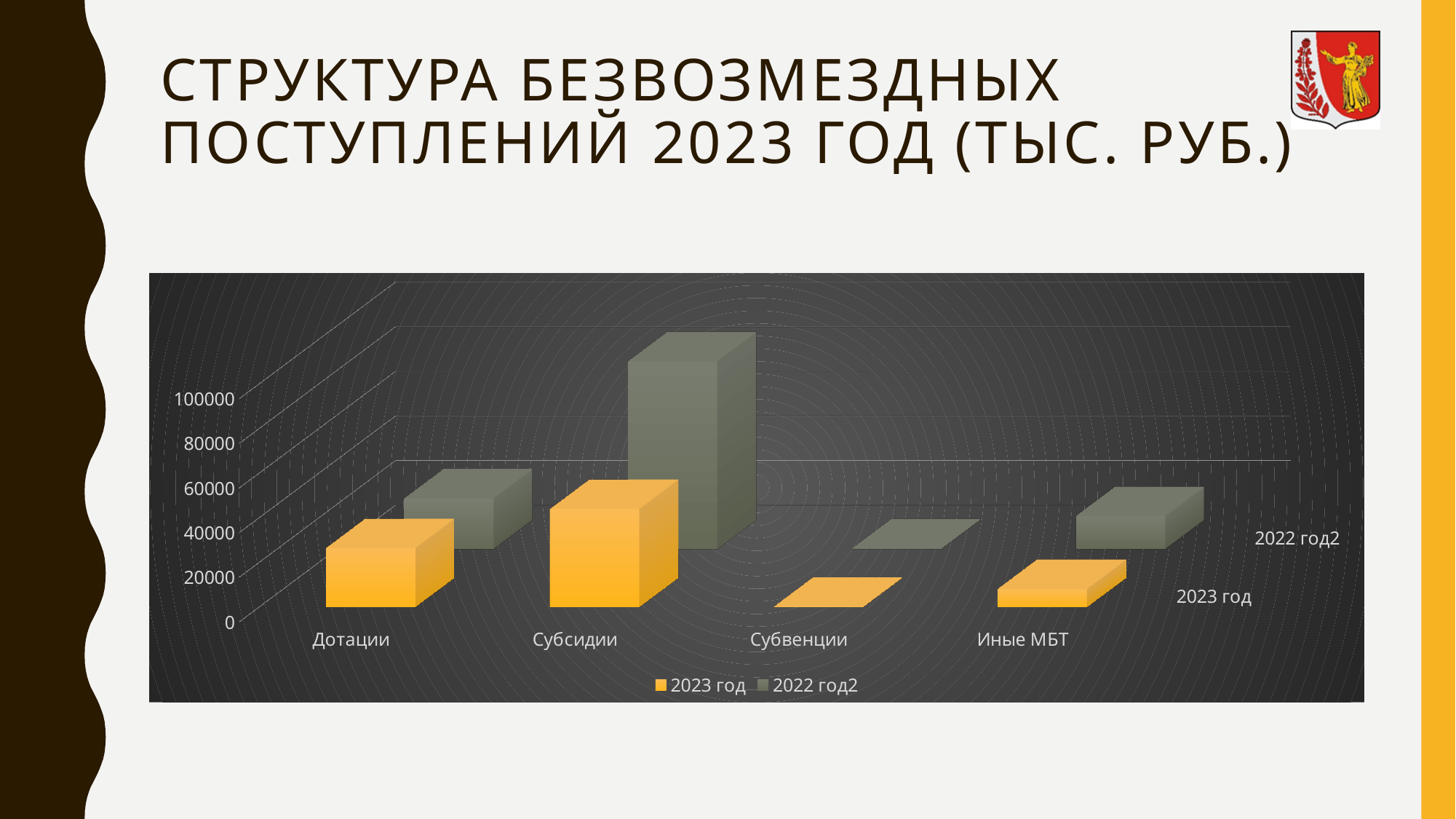
Is the 2023 год value for Субсидии greater or less than 20000? greater Which category has the lowest value for the 2023 год series? Субвенции Which category has the highest value for the 2022 год2 series? Субсидии Is the 2023 год value for Дотации greater or less than 60000? less What kind of chart is shown on the slide? bar chart How many series does the chart legend list? 2 Which category has the lowest value for the 2022 год2 series? Субвенции Is the 2023 год value for Иные МБТ greater or less than 20000? less How many categories are shown on the x axis of the chart? 4 For the 2023 год series, which is larger: Дотации or Субсидии? Субсидии What are the two series names listed in the chart legend? 2023 год and 2022 год2 Which category has the highest value for the 2023 год series? Субсидии